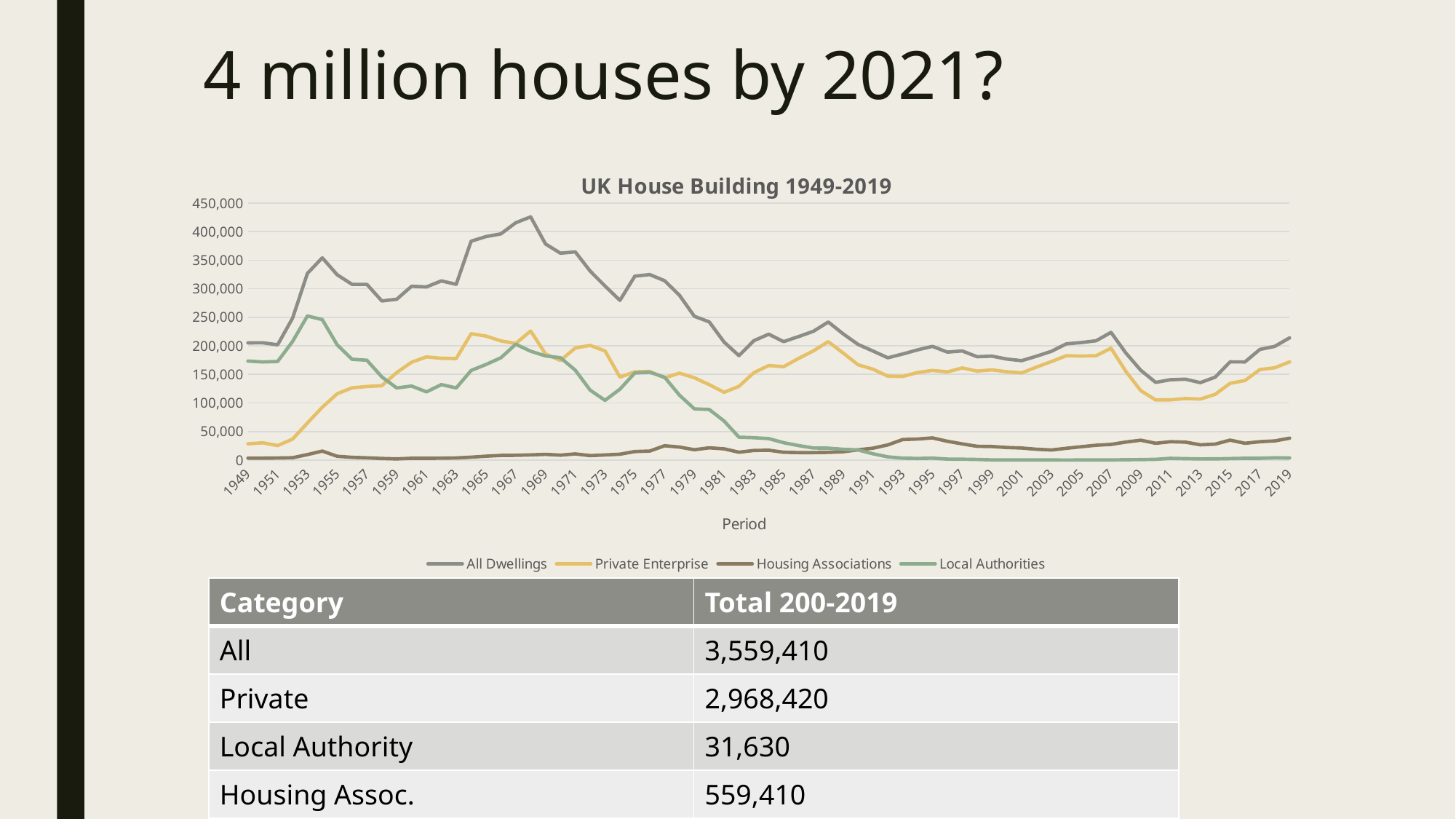
What is the title of the chart? UK House Building 1949-2019 What is the label on the chart's x axis? Period How many series does the chart's legend list? 4 Is the value for Local Authorities in 1953 greater or less than 200,000? greater Is the value for Housing Associations in 2019 greater or less than 50,000? less What kind of chart is shown on the slide? line chart Is the value for Private Enterprise in 1949 greater or less than 50,000? less In 2019, which is larger: Private Enterprise or Housing Associations? Private Enterprise In 1953, which is larger: Local Authorities or Private Enterprise? Local Authorities Which series has the lowest value in 2019? Local Authorities Does the Local Authorities line rise or fall between 1977 and 1995? fall